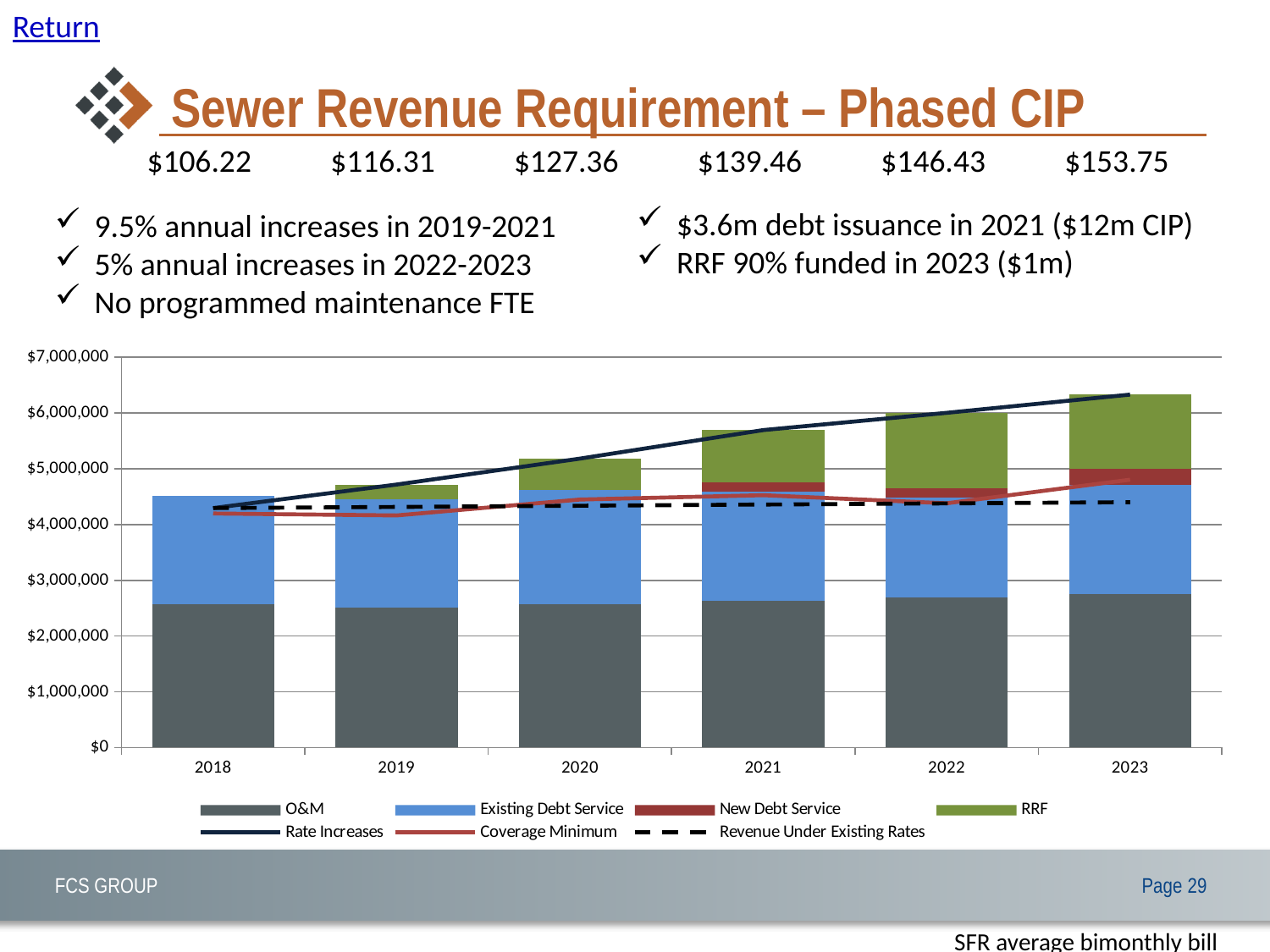
Is the O&M value for 2023 greater or less than $2,000,000? greater Which series is shown as a black dashed line in the legend? Revenue Under Existing Rates What kind of chart is shown on the slide? stacked bar chart with line series Is the total stacked bar for 2018 greater or less than $5,000,000? less Which series is shown in green in the legend? RRF How many years are shown along the x axis of the chart? 6 Is the total stacked bar for 2023 greater or less than $6,000,000? greater Which is larger, the total stacked bar for 2018 or for 2023? 2023 How many series does the chart legend list? 7 Which year has the tallest stacked bar in the chart? 2023 Does the Rate Increases line rise or fall from 2018 to 2023? rise